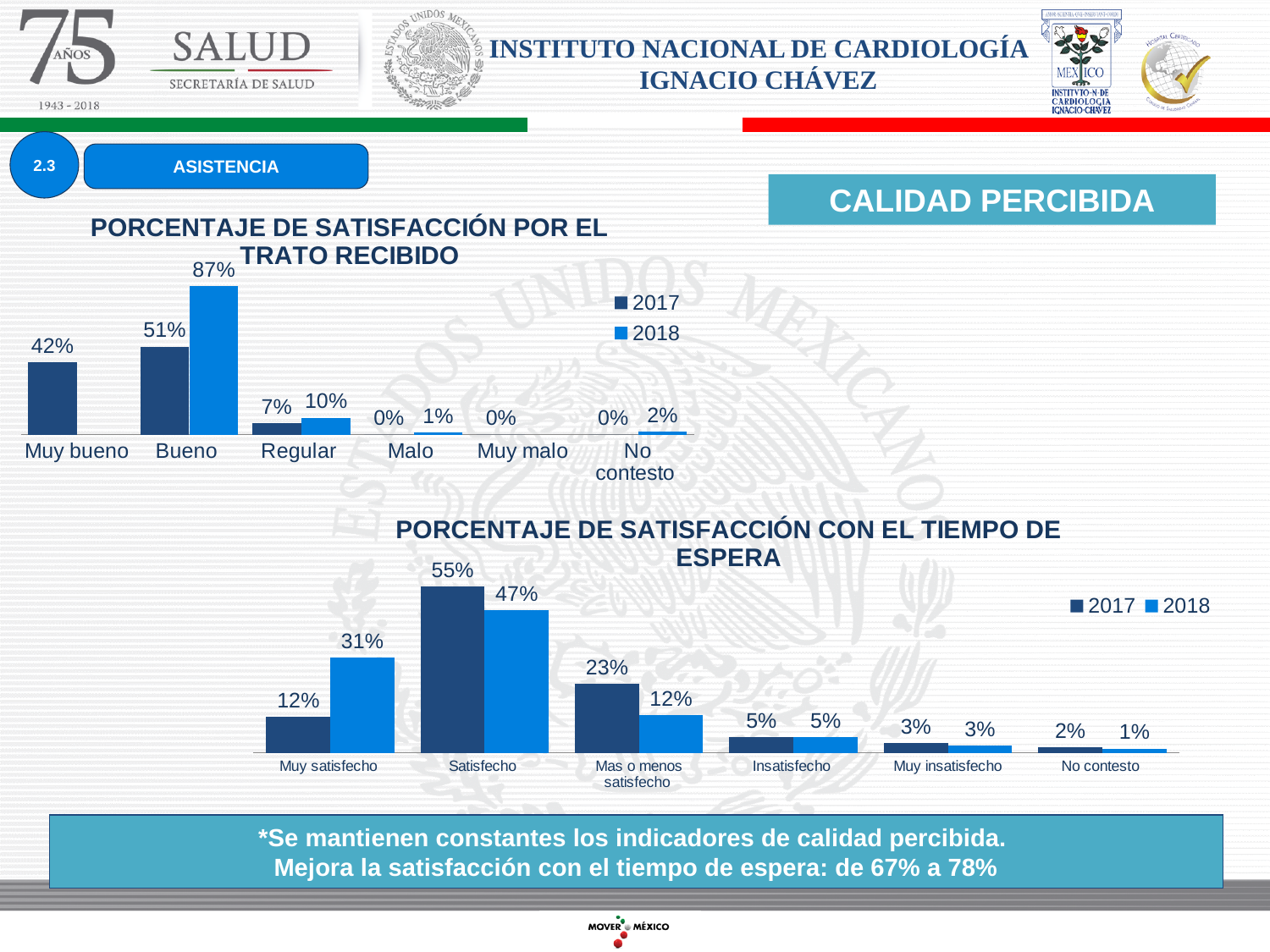
In the chart 'PORCENTAJE DE SATISFACCIÓN CON EL TIEMPO DE ESPERA', what is the 2017 value for Satisfecho? 55% In the chart 'PORCENTAJE DE SATISFACCIÓN POR EL TRATO RECIBIDO', which category has the highest 2017 value? Bueno In the chart 'PORCENTAJE DE SATISFACCIÓN POR EL TRATO RECIBIDO', what is the 2018 value for Bueno? 87% In the chart 'PORCENTAJE DE SATISFACCIÓN POR EL TRATO RECIBIDO', what is the difference between the 2018 and 2017 values for Bueno? 36% What type of chart is 'PORCENTAJE DE SATISFACCIÓN CON EL TIEMPO DE ESPERA'? Bar chart In the chart 'PORCENTAJE DE SATISFACCIÓN CON EL TIEMPO DE ESPERA', which is larger for Mas o menos satisfecho, the 2017 value or the 2018 value? 2017 In the chart 'PORCENTAJE DE SATISFACCIÓN CON EL TIEMPO DE ESPERA', which category has the lowest 2018 value? No contesto In the chart 'PORCENTAJE DE SATISFACCIÓN POR EL TRATO RECIBIDO', how many categories are shown on the x axis? 6 In the chart 'PORCENTAJE DE SATISFACCIÓN POR EL TRATO RECIBIDO', how many series does the legend list? 2 In the chart 'PORCENTAJE DE SATISFACCIÓN CON EL TIEMPO DE ESPERA', what is the 2018 value for Muy satisfecho? 31% In the chart 'PORCENTAJE DE SATISFACCIÓN CON EL TIEMPO DE ESPERA', what is the difference between the 2017 and 2018 values for Mas o menos satisfecho? 11% In the chart 'PORCENTAJE DE SATISFACCIÓN POR EL TRATO RECIBIDO', what is the 2017 value for Muy bueno? 42%